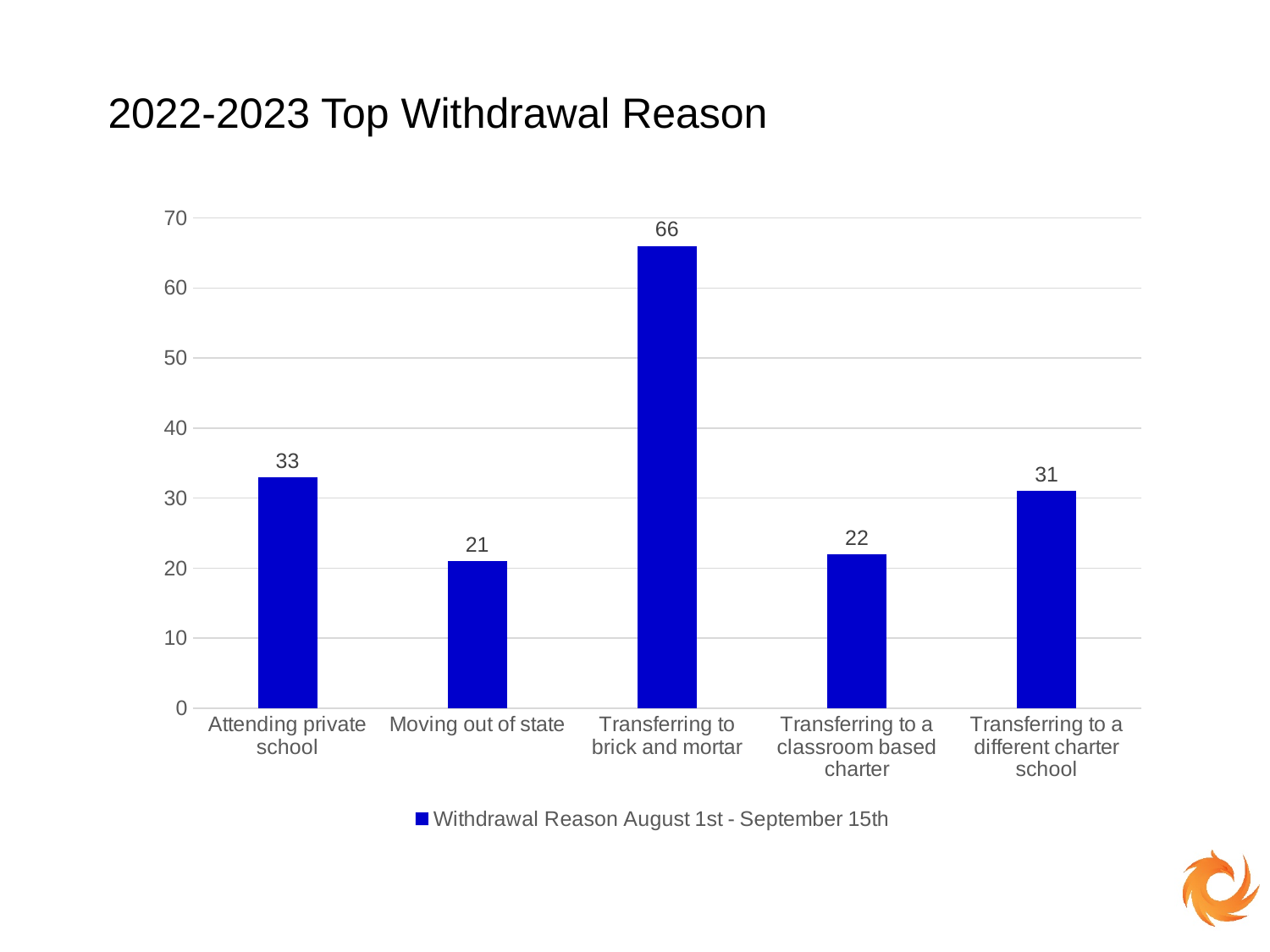
Which is larger, the value for Attending private school or the value for Transferring to a classroom based charter? Attending private school Which withdrawal reason has the lowest value? Moving out of state What kind of chart is shown on the slide? bar chart Is the value for Transferring to a classroom based charter greater or less than 30? less What is the value for Transferring to a different charter school? 31 What series does the legend list? Withdrawal Reason August 1st - September 15th Which withdrawal reason has the highest value? Transferring to brick and mortar What is the difference between the values for Attending private school and Transferring to a different charter school? 2 What is the value for Moving out of state? 21 What is the value for Transferring to brick and mortar? 66 How many withdrawal reasons are shown on the chart? 5 What is the difference between the values for Transferring to brick and mortar and Attending private school? 33